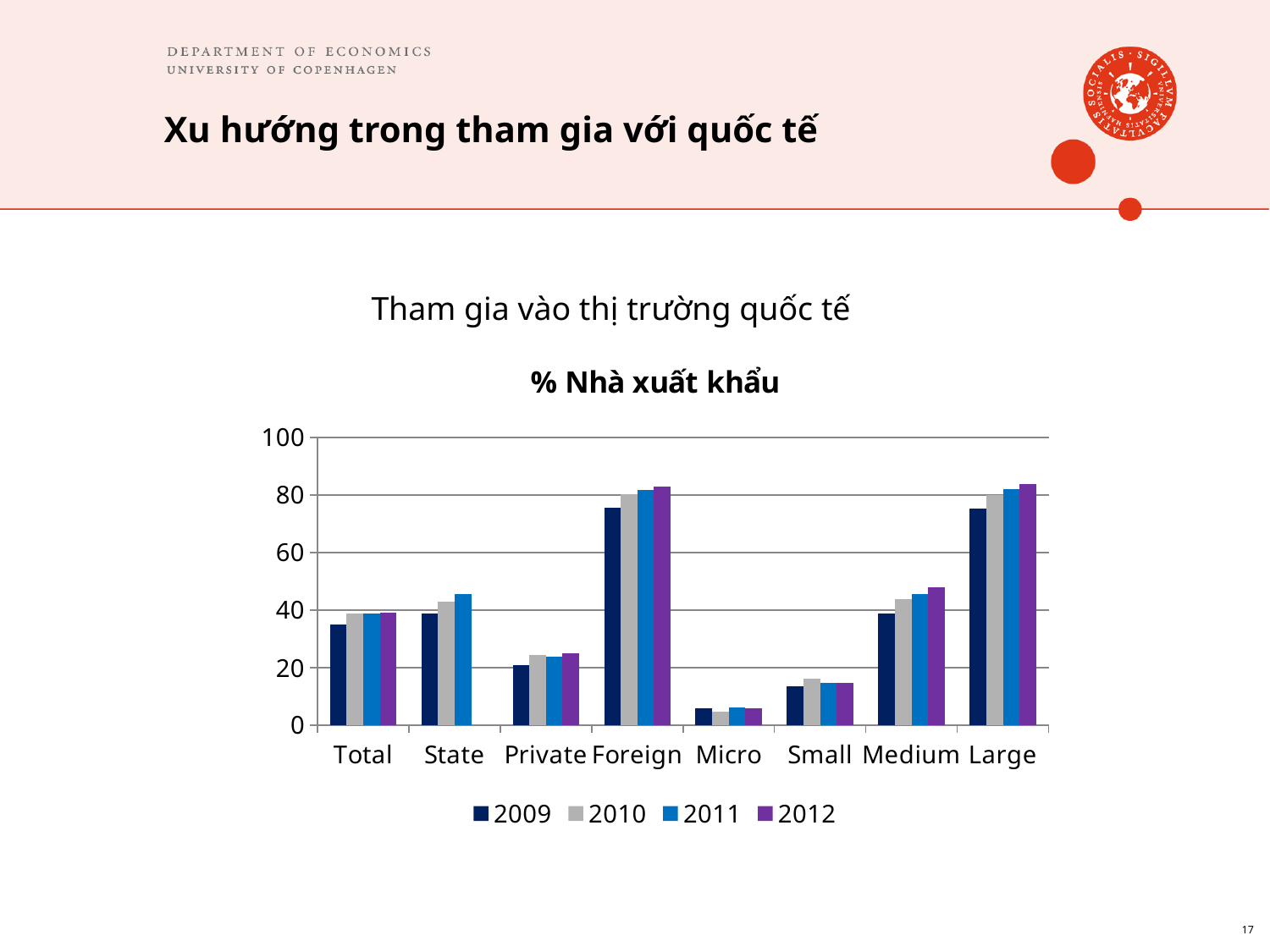
Which category has the lowest values in the chart? Micro Is the 2009 value for Private greater or less than 40? less Which is larger, the 2012 value for Large or the 2012 value for Small? Large How many categories are shown on the x axis of the chart? 8 Is the 2012 value for Foreign greater or less than 80? greater What kind of chart is shown on the slide? bar chart Is the 2010 value for Micro greater or less than 20? less Which years are listed in the chart's legend? 2009, 2010, 2011, 2012 How many series does the chart's legend list? 4 What is the title of the chart? % Nhà xuất khẩu Do the values for Medium rise or fall from 2009 to 2012? rise